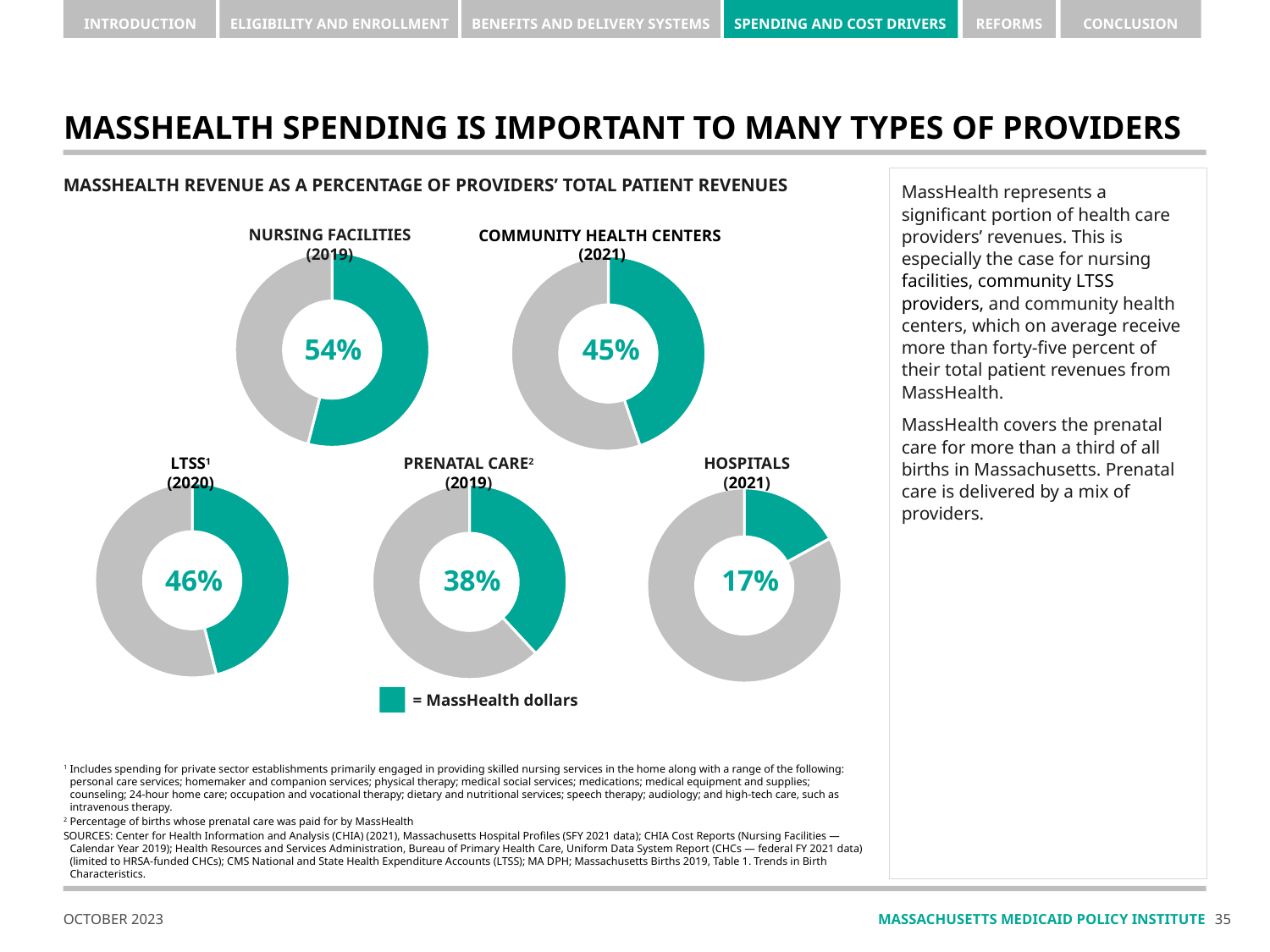
In the Hospitals (2021) chart, what percentage of total patient revenues comes from MassHealth? 17% How many donut charts are shown on the slide? 5 In the LTSS (2020) chart, what percentage of total patient revenues comes from MassHealth? 46% Across the five donut charts on the slide, which provider type has the lowest MassHealth share of total patient revenues? Hospitals Across the five donut charts on the slide, which provider type has the highest MassHealth share of total patient revenues? Nursing Facilities In the Prenatal Care (2019) chart, what percentage is shown for MassHealth dollars? 38% In the Nursing Facilities (2019) chart, what percentage of total patient revenues comes from MassHealth? 54% Which is larger: the MassHealth share shown in the LTSS chart or the one shown in the Prenatal Care chart? LTSS What kind of chart is used to show the Hospitals (2021) value? Donut (pie) chart According to the legend, what does the teal colour in the charts represent? MassHealth dollars What is the difference in percentage points between the Nursing Facilities chart value and the Hospitals chart value? 37 In the Community Health Centers (2021) chart, what percentage of total patient revenues comes from MassHealth? 45%